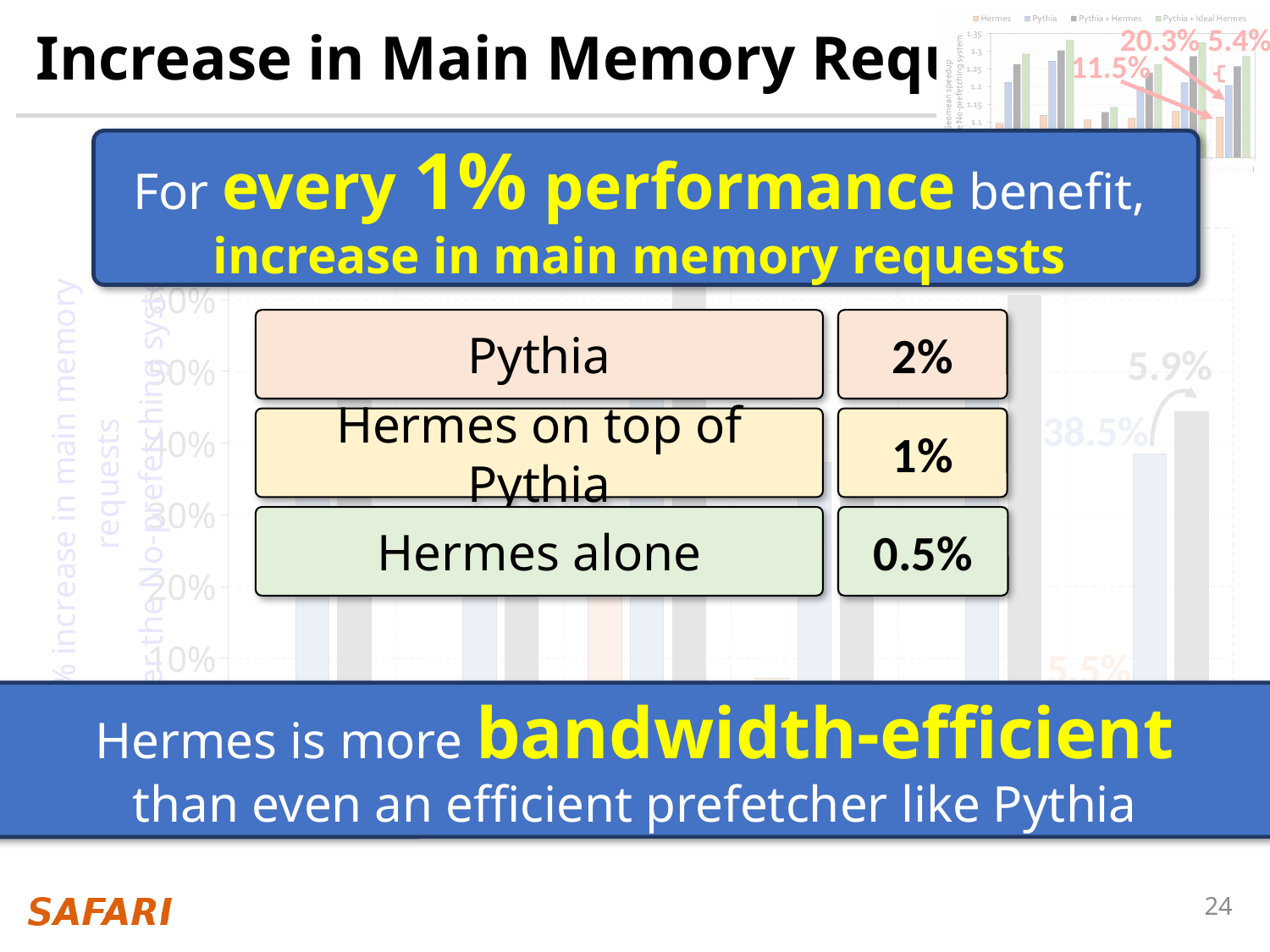
According to the summary boxes, what is the increase in main memory requests for every 1% performance benefit for Hermes alone? 0.5% In the summary boxes, what is the difference between the value for Pythia and the value for Hermes alone? 1.5% What kind of chart is the large chart in the background of the slide? bar chart In the summary boxes, which is larger: the value for Hermes on top of Pythia or the value for Hermes alone? Hermes on top of Pythia According to the summary boxes, what is the increase in main memory requests for every 1% performance benefit for Pythia? 2% Among the three summary boxes, which configuration has the lowest increase in main memory requests per 1% performance benefit? Hermes alone What kind of chart is the small inset chart in the top-right corner? bar chart According to the summary boxes, what is the increase in main memory requests for every 1% performance benefit for Hermes on top of Pythia? 1% How many series does the legend of the small inset chart in the top-right corner list? 4 Among the three summary boxes, which configuration has the highest increase in main memory requests per 1% performance benefit? Pythia What is the highest y-axis tick shown on the large background bar chart? 60% What are the legend entries of the small inset chart in the top-right corner? Hermes, Pythia, Pythia + Hermes, Pythia + Ideal Hermes